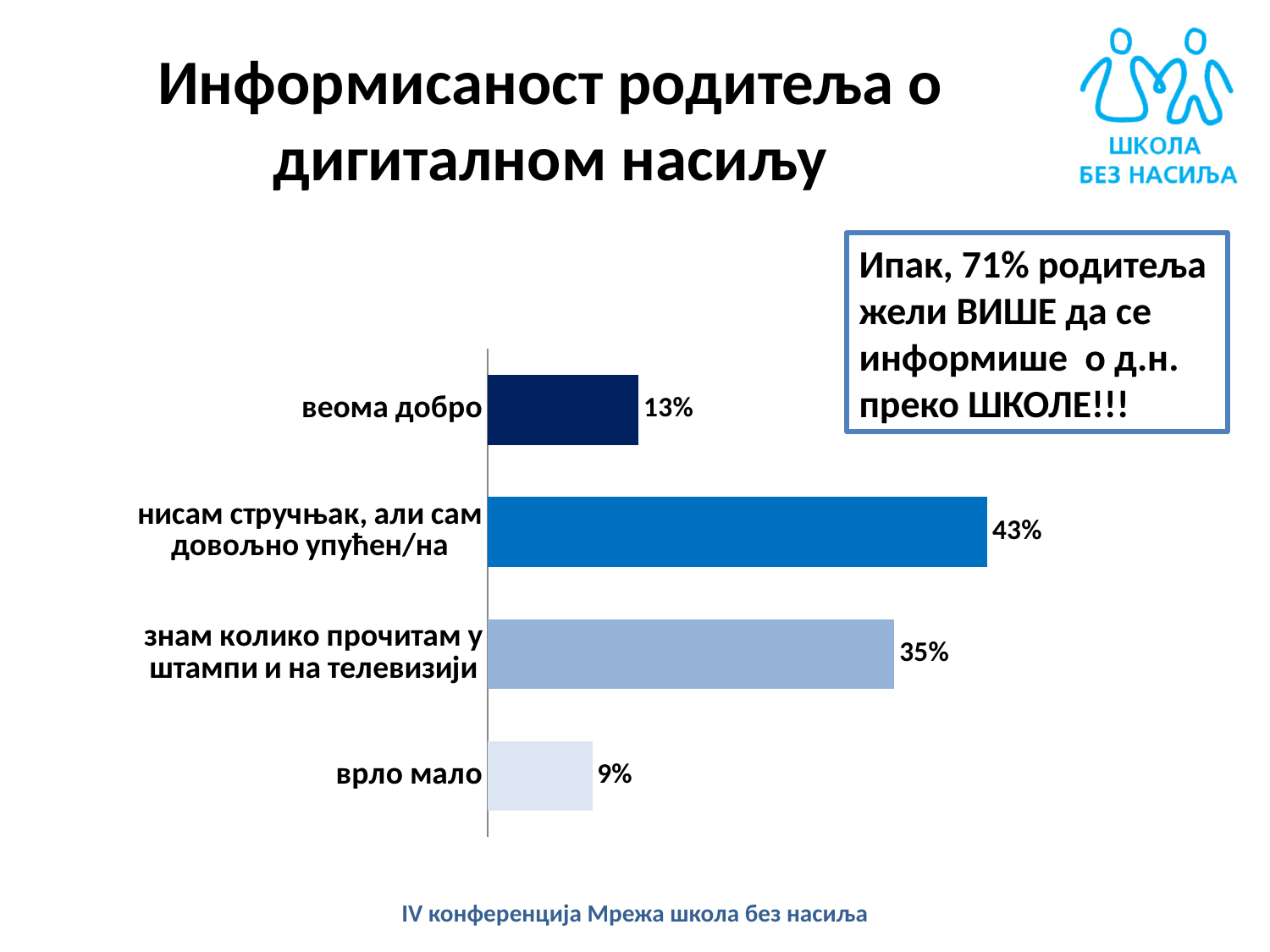
Which category has the highest value? нисам стручњак, али сам довољно упућен/на What kind of chart is shown on the slide? bar chart How many categories are shown in the chart? 4 What is the title of the slide containing the chart? Информисаност родитеља о дигиталном насиљу What is the difference between the values for "нисам стручњак, али сам довољно упућен/на" and "знам колико прочитам у штампи и на телевизији"? 8% Which category has the lowest value? врло мало Which is larger, the value for "веома добро" or the value for "врло мало"? веома добро What is the value for "врло мало"? 9% What is the difference between the values for "веома добро" and "врло мало"? 4% What is the value for "знам колико прочитам у штампи и на телевизији"? 35% What is the value for "нисам стручњак, али сам довољно упућен/на"? 43% What is the value for "веома добро"? 13%